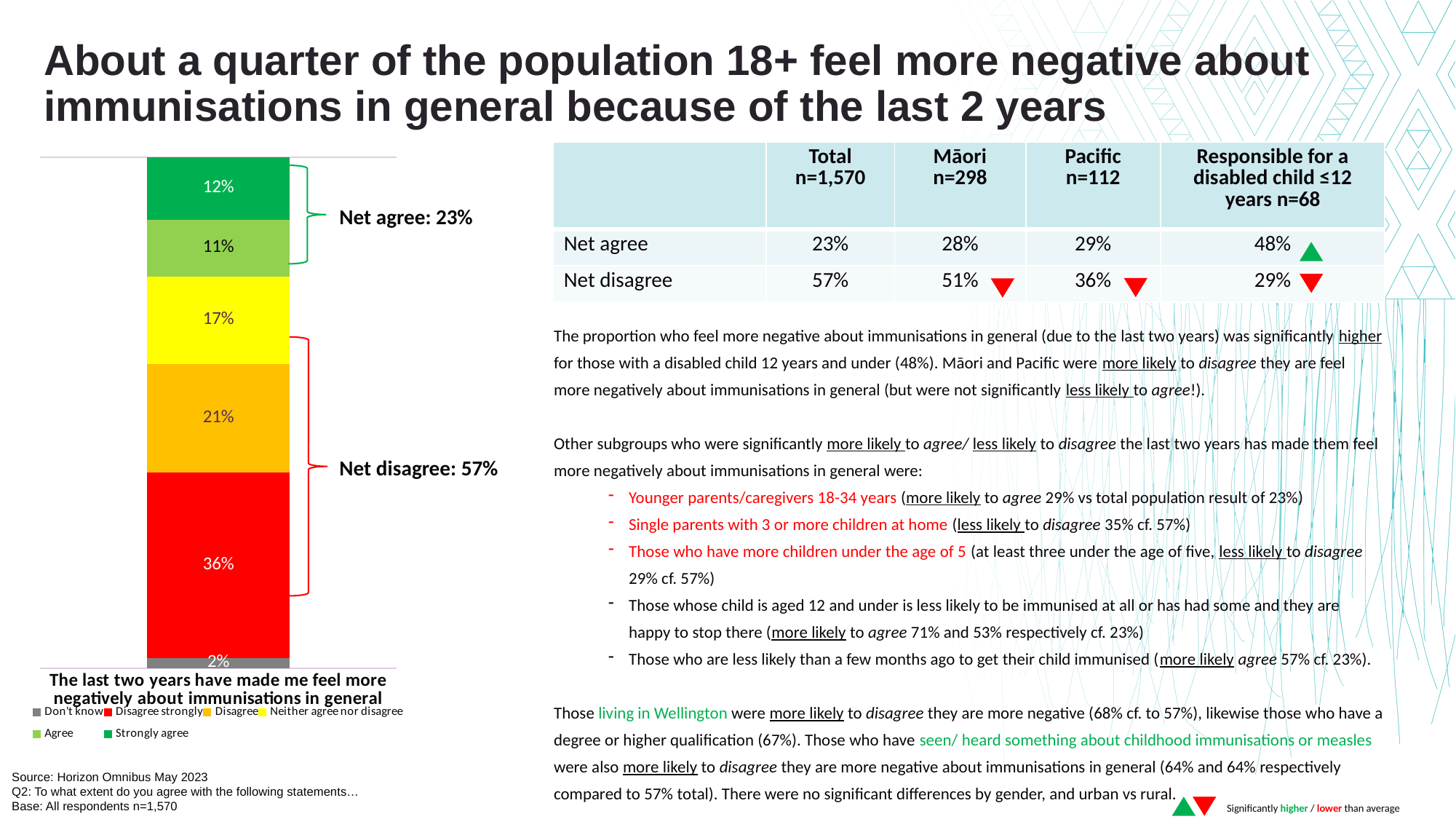
Which response category has the smallest share in the chart? Don't know What type of chart is shown on the slide? Stacked bar chart Which is larger in the chart: the 'Agree' share or the 'Neither agree nor disagree' share? Neither agree nor disagree Which response category has the largest share in the chart? Disagree strongly What is the net disagree figure annotated next to the chart? Net disagree: 57% What is the net agree figure annotated next to the chart? Net agree: 23% How many response categories does the chart's legend list? 6 What percentage of respondents answered 'Don't know' in the chart? 2% What percentage of respondents strongly agree that the last two years have made them feel more negatively about immunisations in general? 12% What percentage of respondents disagree strongly with the statement in the chart? 36% What is the difference between the 'Disagree strongly' and 'Disagree' percentages in the chart? 15% What percentage of respondents neither agree nor disagree with the statement in the chart? 17%